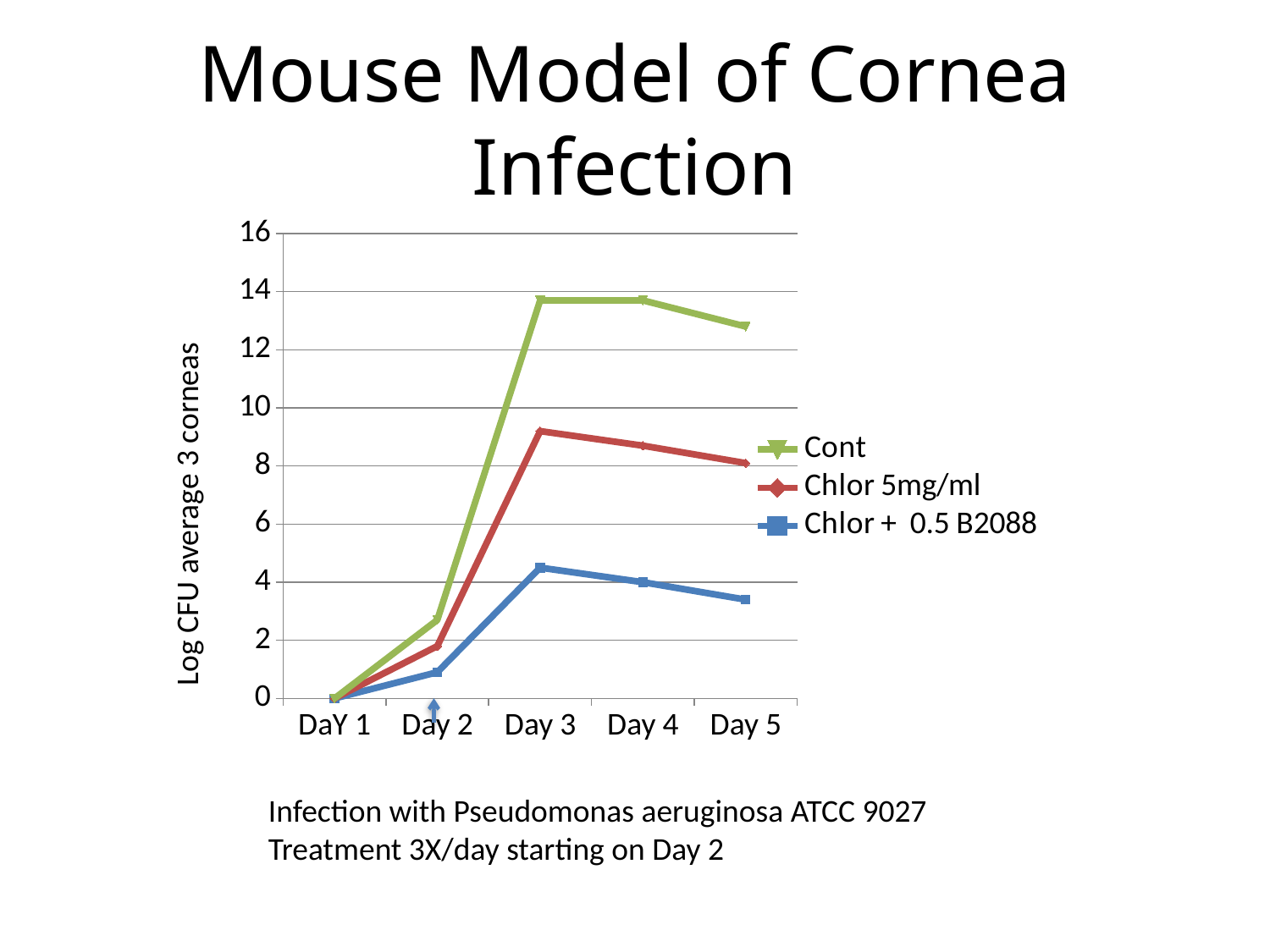
What is the value for Cont on DaY 1? 0 Is the value for Chlor 5mg/ml on Day 5 greater or less than 10? less Does the Cont series rise or fall from Day 3 to Day 5? fall How many days are plotted along the x axis? 5 On Day 4, which is larger: the value for Cont or the value for Chlor 5mg/ml? Cont Which series has the highest value on Day 3? Cont What is the title of the y axis? Log CFU average 3 corneas How many series does the legend list? 3 Is the value for Chlor + 0.5 B2088 on Day 3 greater or less than 6? less Is the value for Cont on Day 3 greater or less than 12? greater What kind of chart is shown on the slide? line chart Which series has the lowest value on Day 5? Chlor + 0.5 B2088